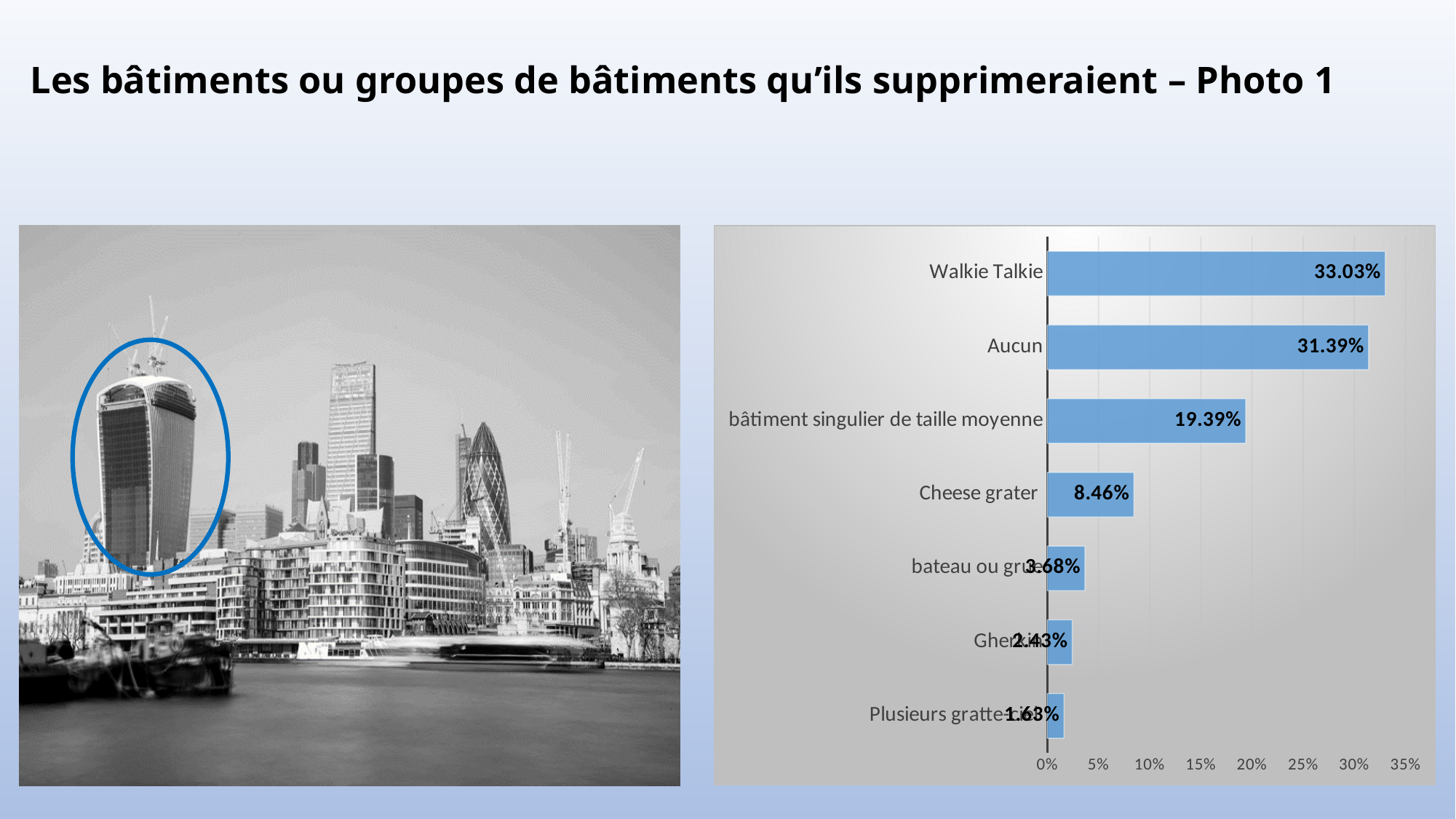
What is the value for Walkie Talkie? 33.03% What is the lowest value shown on the chart? 1.63% What is the difference between the values for Walkie Talkie and Aucun? 1.64% What is the value for Cheese grater? 8.46% Which category has the highest value? Walkie Talkie Is the value for Cheese grater greater or less than 10%? less What is the value for Aucun? 31.39% What is the maximum value shown on the chart's horizontal axis? 35% What is the value for bâtiment singulier de taille moyenne? 19.39% How many categories (bars) does the chart show? 7 What type of chart is shown on the slide? bar chart Which is larger, the value for Cheese grater or the value for bâtiment singulier de taille moyenne? bâtiment singulier de taille moyenne